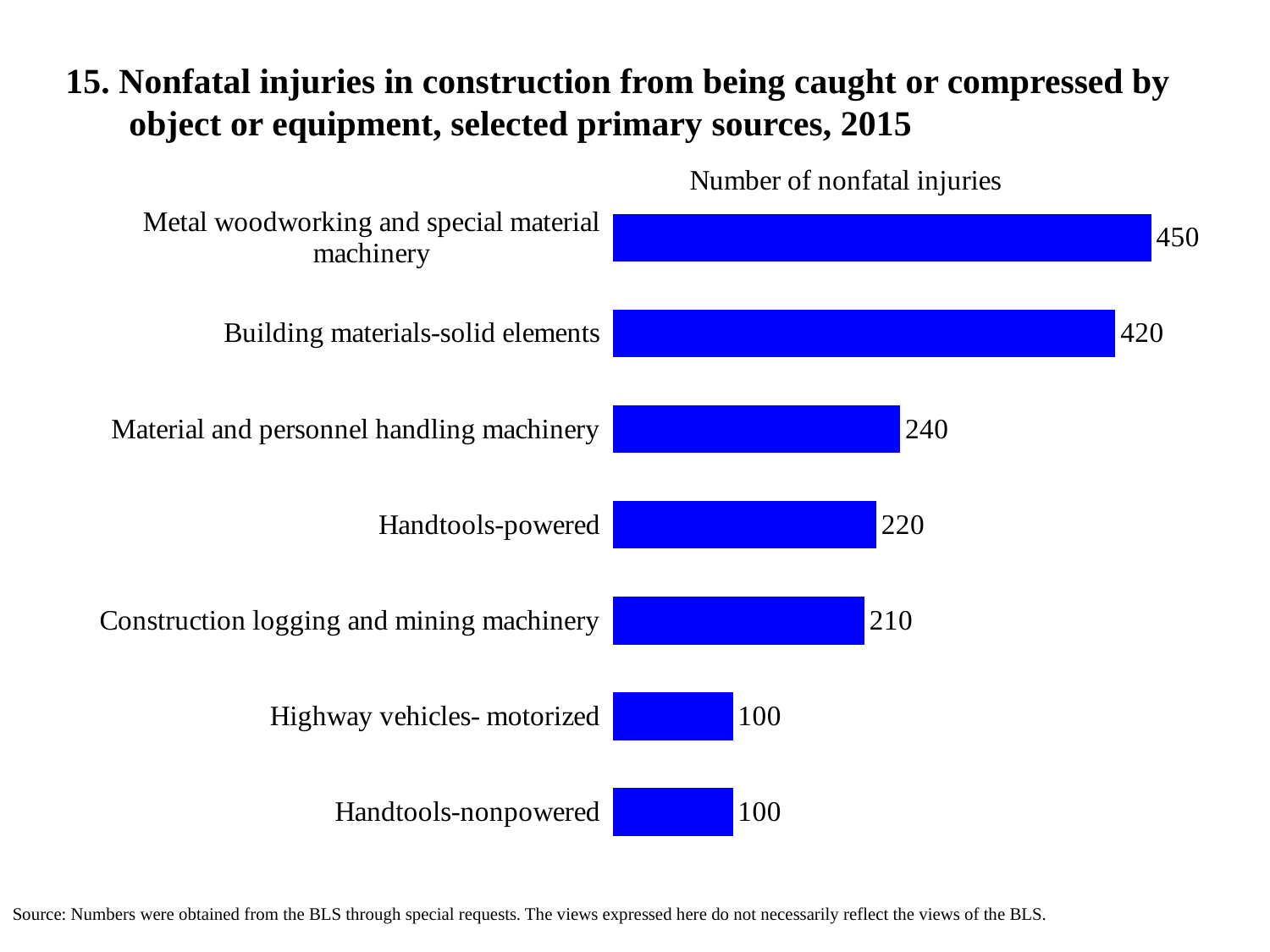
How many primary source categories are shown in the chart? 7 What is the difference in nonfatal injuries between Metal woodworking and special material machinery and Building materials-solid elements? 30 What is the difference in nonfatal injuries between Material and personnel handling machinery and Handtools-nonpowered? 140 What is the number of nonfatal injuries for Building materials-solid elements? 420 Which two categories share the lowest value of 100 nonfatal injuries? Highway vehicles- motorized and Handtools-nonpowered What is the number of nonfatal injuries for Handtools-powered? 220 Which primary source has the highest number of nonfatal injuries? Metal woodworking and special material machinery What year does the chart's data refer to? 2015 Which has more nonfatal injuries, Material and personnel handling machinery or Handtools-powered? Material and personnel handling machinery What is the number of nonfatal injuries for Construction logging and mining machinery? 210 What is the axis label shown above the bars? Number of nonfatal injuries What kind of chart is shown on the slide? Bar chart